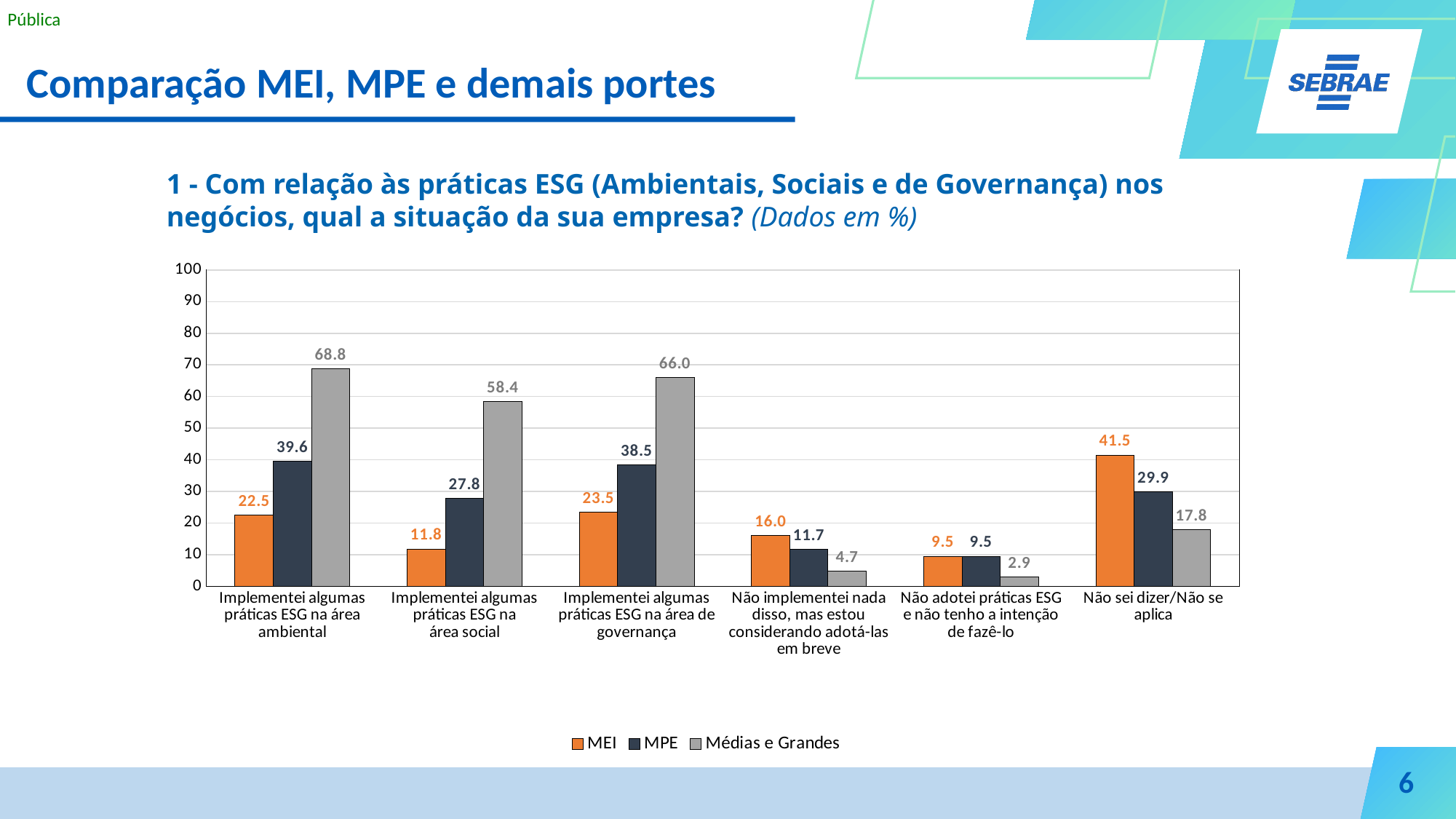
What is the value for MEI in the category 'Implementei algumas práticas ESG na área ambiental'? 22.5 What kind of chart is shown on the slide? Bar chart How many series does the legend list? 3 In the category 'Não implementei nada disso, mas estou considerando adotá-las em breve', which series has the larger value, MEI or MPE? MEI Is the value for MEI in the category 'Não sei dizer/Não se aplica' greater or less than 40? greater Which series is shown in orange in the chart? MEI Which category has the highest value for the Médias e Grandes series? Implementei algumas práticas ESG na área ambiental How many categories are shown on the x axis of the chart? 6 What is the value for MPE in the category 'Não sei dizer/Não se aplica'? 29.9 What is the difference between the Médias e Grandes value and the MEI value in the category 'Implementei algumas práticas ESG na área social'? 46.6 Which category has the lowest value for the Médias e Grandes series? Não adotei práticas ESG e não tenho a intenção de fazê-lo What is the value for Médias e Grandes in the category 'Implementei algumas práticas ESG na área de governança'? 66.0